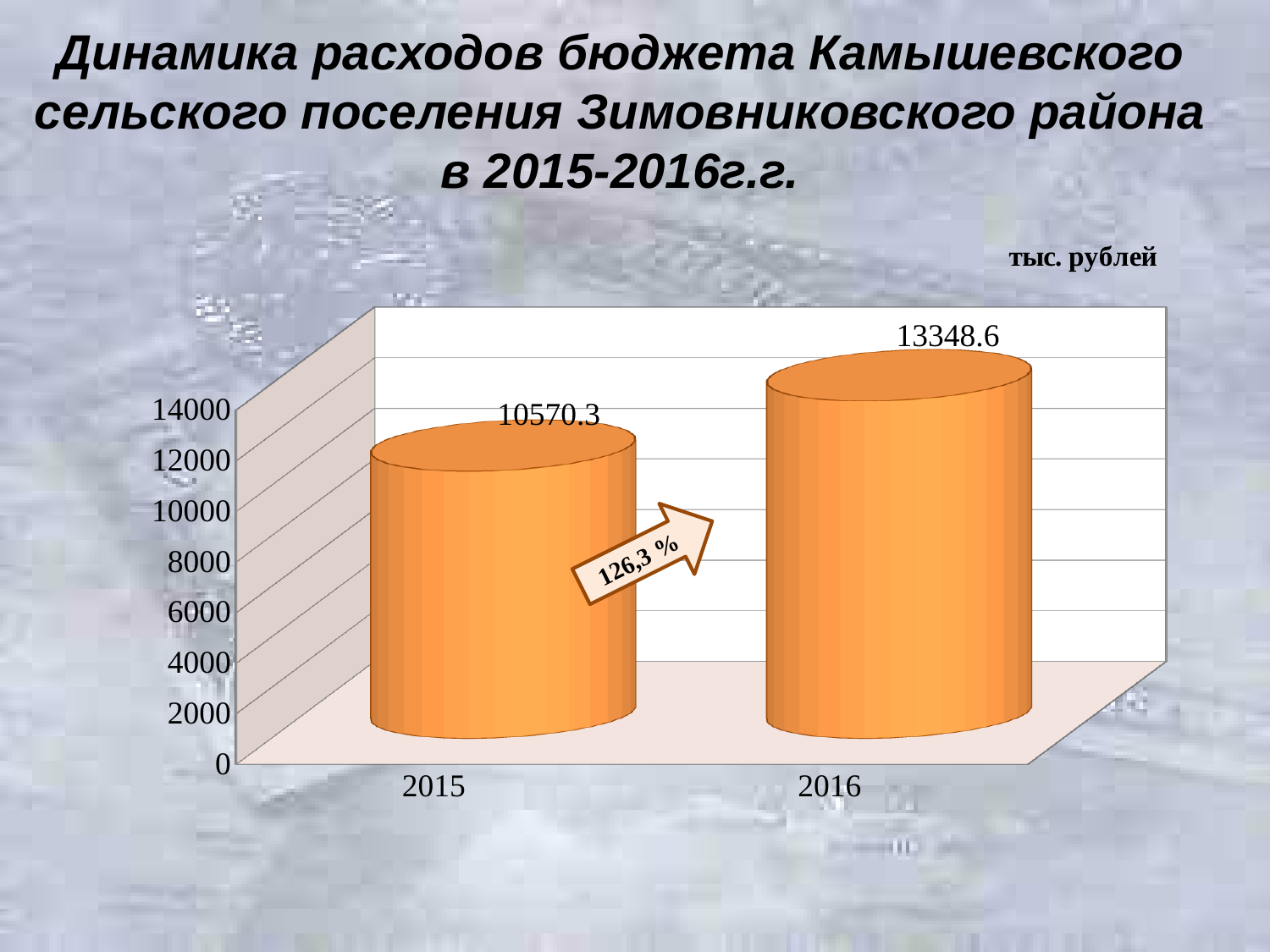
Is the value for 2015 greater or less than 12000? less Which year has the lowest value? 2015 Do the values rise or fall from 2015 to 2016? rise Which is larger, the value for 2015 or the value for 2016? 2016 Is the value for 2016 greater or less than 12000? greater What is the difference between the values for 2016 and 2015? 2778.3 Which year has the highest value? 2016 What kind of chart is shown on the slide? bar chart What is the value for 2015? 10570.3 How many categories are shown on the x axis? 2 What is the value for 2016? 13348.6 What percentage is written on the arrow between the two bars? 126,3 %